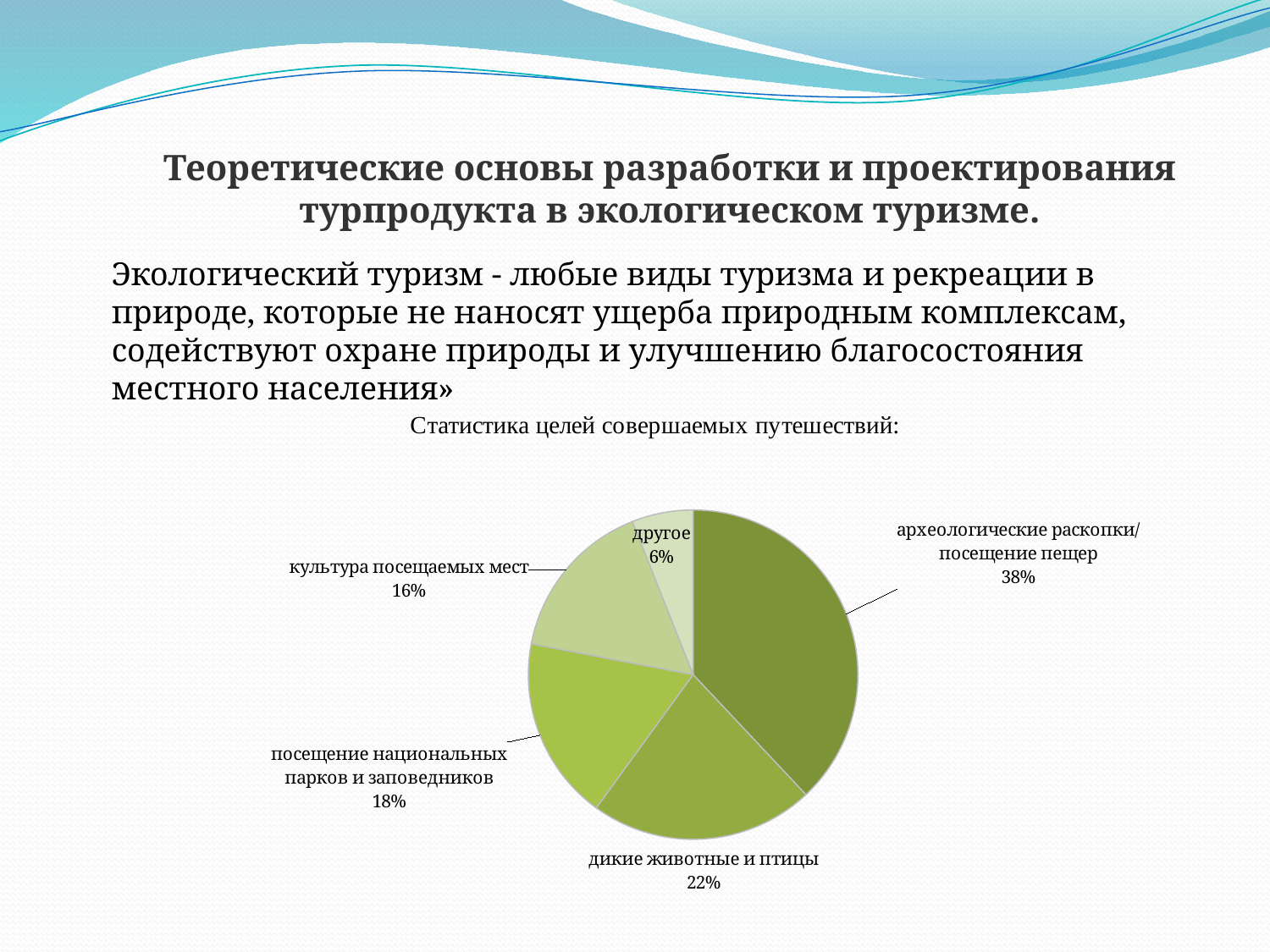
What share of the pie is 'культура посещаемых мест'? 16% Which category has the smallest share of the pie? другое What is the difference in percentage points between 'археологические раскопки/ посещение пещер' and 'дикие животные и птицы'? 16 What share of the pie is 'другое'? 6% What kind of chart is shown on the slide? pie chart What share of the pie is 'дикие животные и птицы'? 22% What share of the pie is 'археологические раскопки/ посещение пещер'? 38% Which category has the largest share of the pie? археологические раскопки/ посещение пещер Which is larger: 'посещение национальных парков и заповедников' or 'культура посещаемых мест'? посещение национальных парков и заповедников What share of the pie is 'посещение национальных парков и заповедников'? 18% What is the title of the chart? Статистика целей совершаемых путешествий: How many slices does the pie chart have? 5